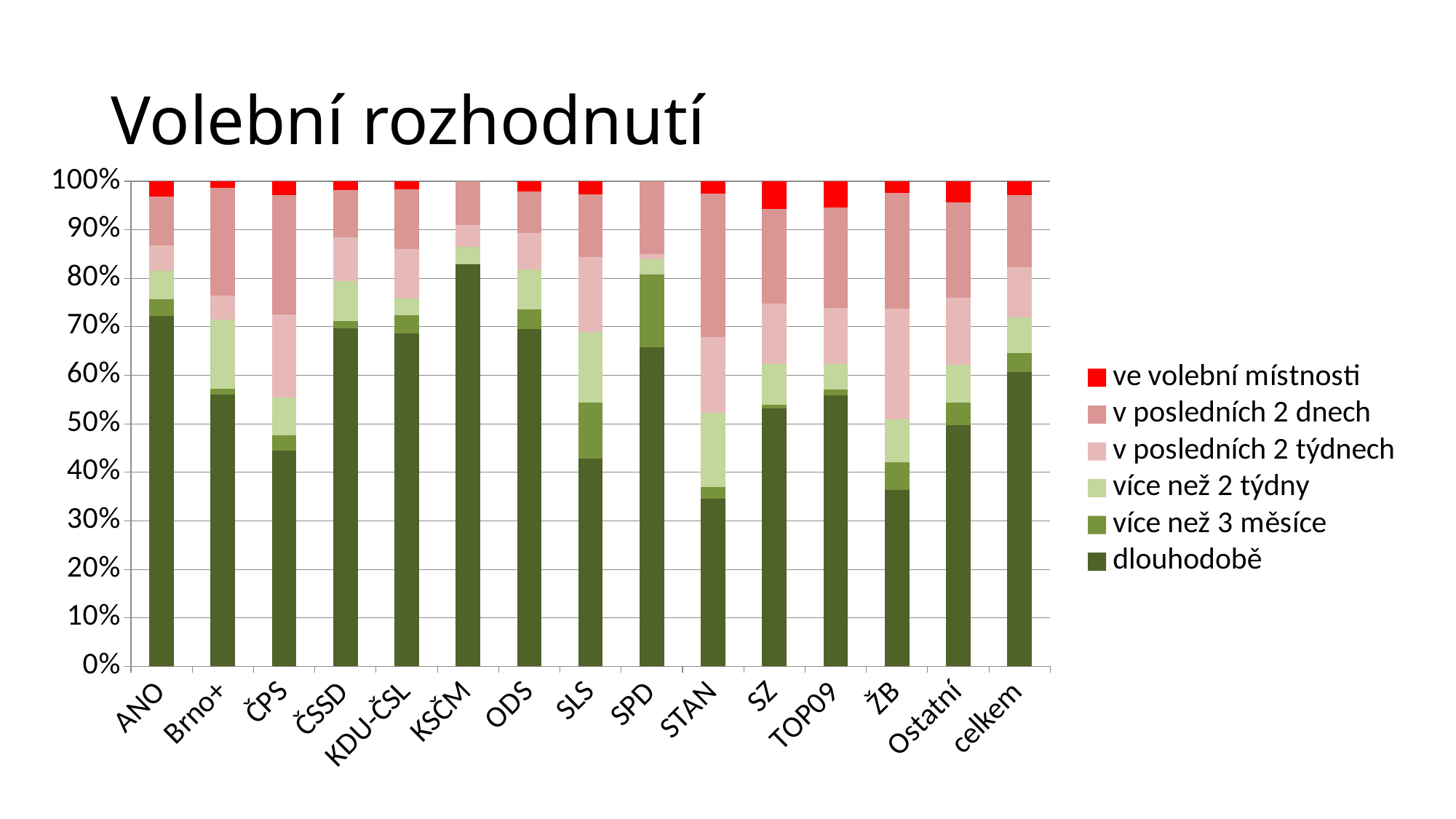
How many categories are shown along the x axis? 15 What is the title of the chart? Volební rozhodnutí Which legend entry is shown in red? ve volební místnosti Which has a larger 'dlouhodobě' segment, Brno+ or ŽB? Brno+ How many series does the legend list? 6 Is the 'dlouhodobě' value for celkem greater or less than 50%? greater Is the 'dlouhodobě' value for ČPS greater or less than 50%? less Is the 'dlouhodobě' value for KSČM greater or less than 80%? greater Which category has the largest 'dlouhodobě' segment? KSČM Which category has the smallest 'dlouhodobě' segment? STAN What kind of chart is shown on the slide? stacked bar chart